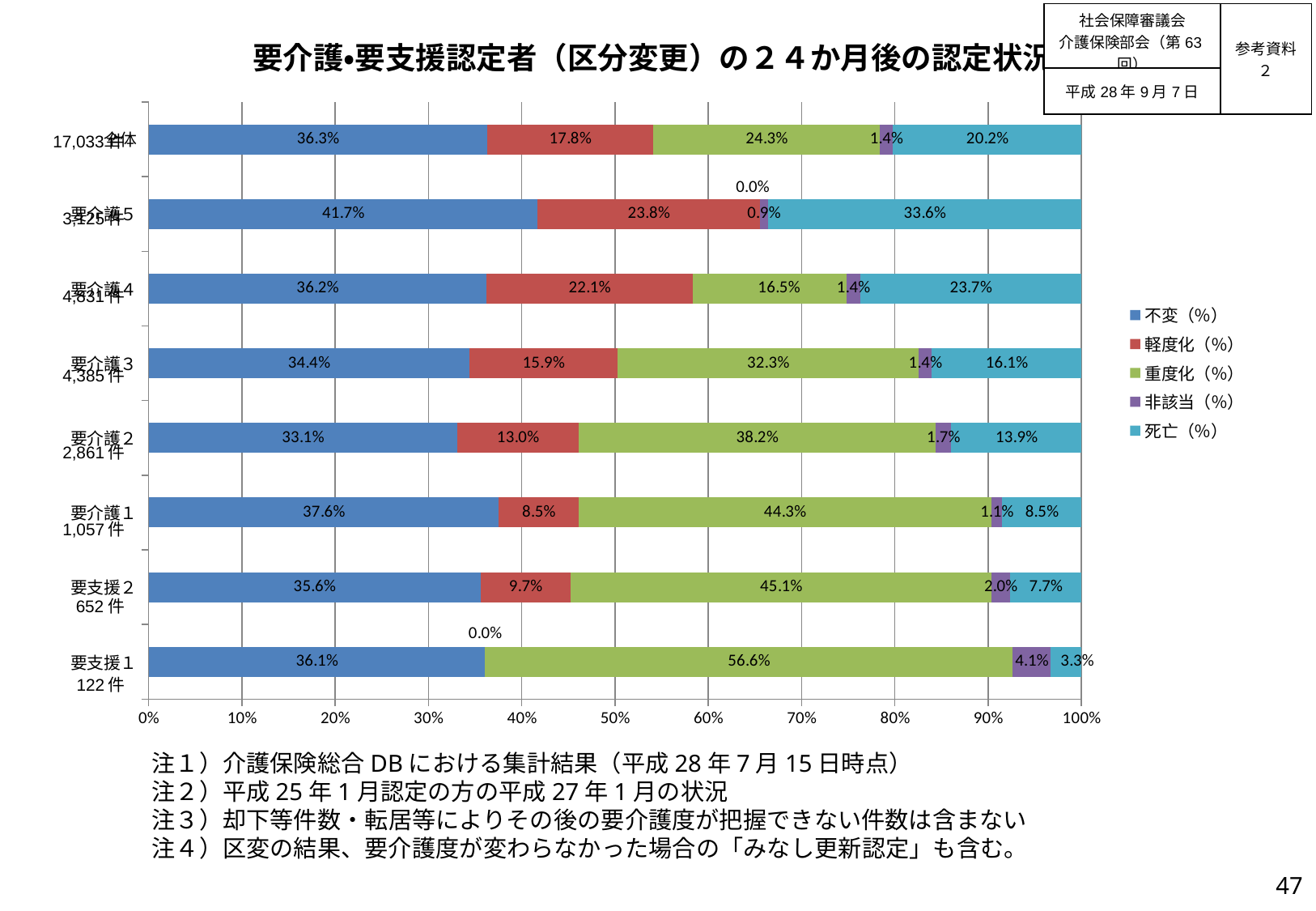
What is the 軽度化 (%) value for 要介護3? 15.9% How many categories (bars) are shown in the chart? 8 Which is larger, the 軽度化 (%) value for 要介護2 or for 要支援2? 要介護2 What is the 重度化 (%) value for 要支援1? 56.6% What is the 死亡 (%) value for 全体? 20.2% How many series does the legend list? 5 Which series is shown in green in the legend? 重度化（%） What is the difference between the 重度化 (%) values for 要介護2 and 要介護3? 5.9% What is the 不変 (%) value for 要介護1? 37.6% What kind of chart is shown on the slide? Stacked bar chart Which category has the lowest 死亡 (%) value? 要支援1 Which category has the highest 重度化 (%) value? 要支援1